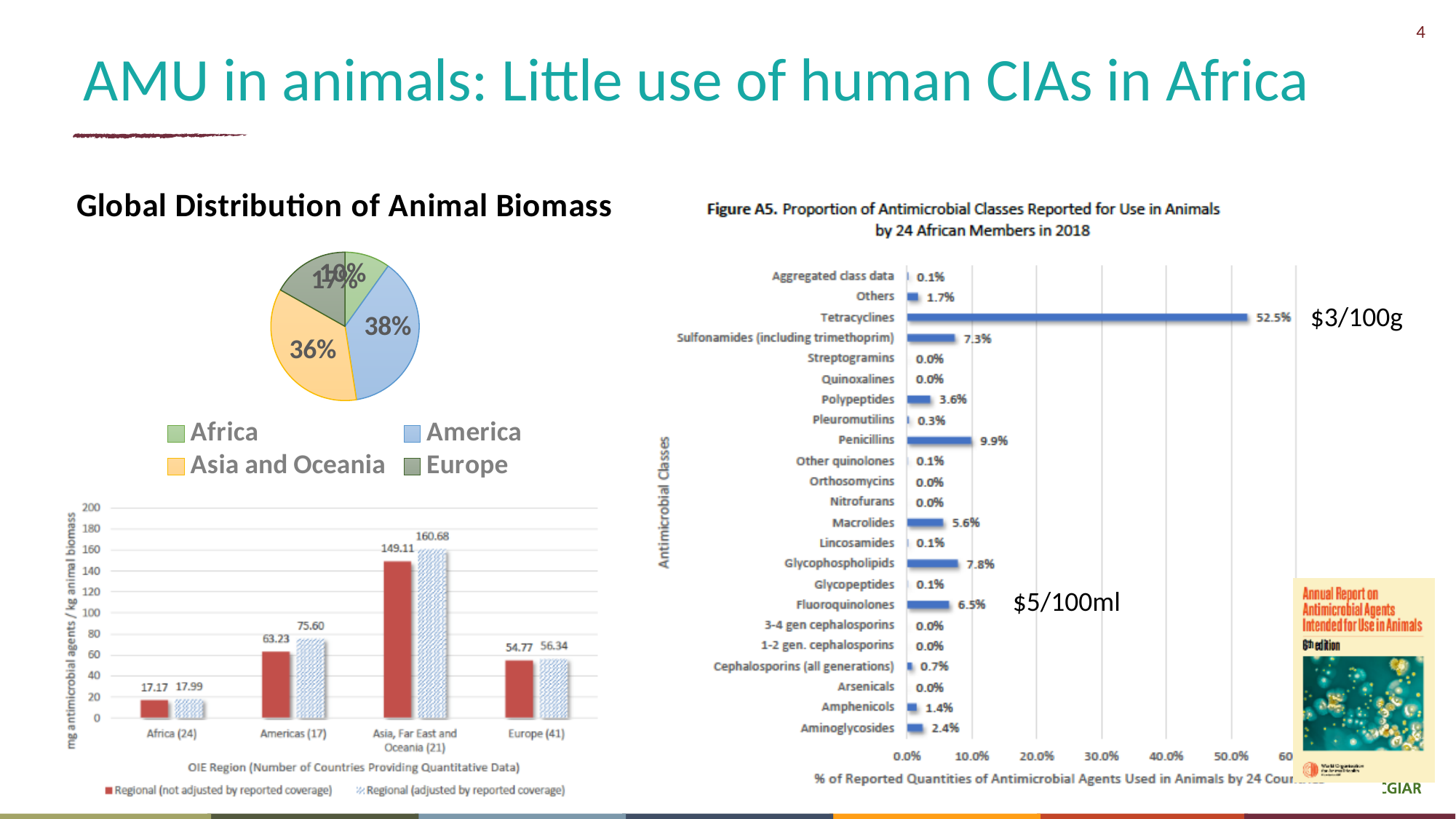
In Figure A5, which is larger, the proportion for Fluoroquinolones or for Macrolides? Fluoroquinolones How many regions does the legend of the Global Distribution of Animal Biomass pie chart list? 4 In the Global Distribution of Animal Biomass pie chart, what share does Asia and Oceania have? 36% In the bar chart of mg antimicrobial agents per kg animal biomass, what is the adjusted value for Asia, Far East and Oceania (21)? 160.68 In the bar chart of mg antimicrobial agents per kg animal biomass, how many series does the legend list? 2 In the Global Distribution of Animal Biomass pie chart, what share does America have? 38% In the bar chart of mg antimicrobial agents per kg animal biomass, what is the not-adjusted value for Africa (24)? 17.17 In Figure A5, which antimicrobial class has the highest proportion? Tetracyclines What kind of chart is Figure A5? Bar chart In the bar chart of mg antimicrobial agents per kg animal biomass, which OIE region has the lowest values? Africa (24) In Figure A5, what is the proportion for Penicillins? 9.9% In the bar chart of mg antimicrobial agents per kg animal biomass, what is the difference between the adjusted and not-adjusted values for Americas (17)? 12.37